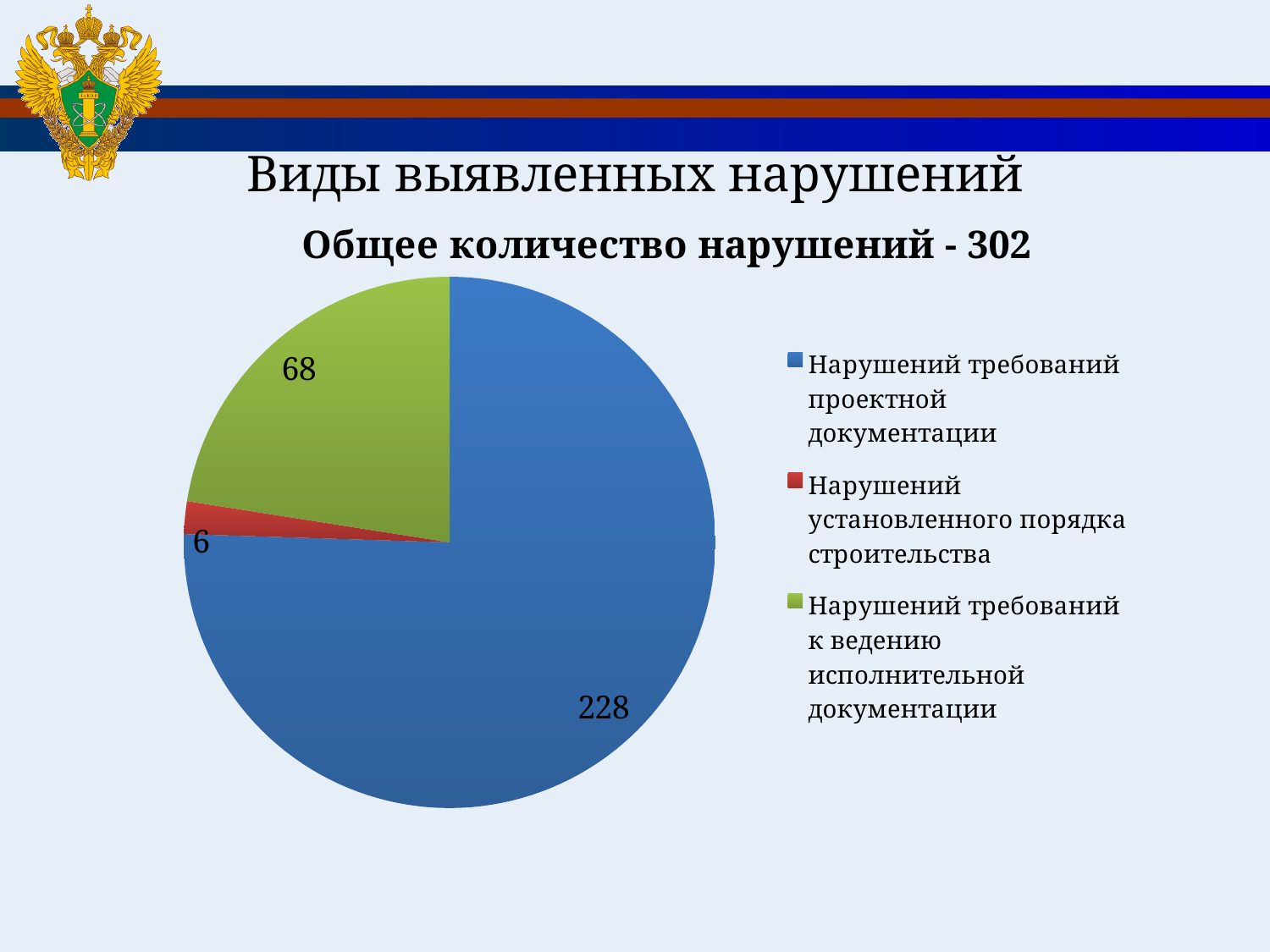
What colour is the slice for 'Нарушений требований к ведению исполнительной документации'? Green What is the value for 'Нарушений требований к ведению исполнительной документации'? 68 How many categories does the pie chart have? 3 Which category has the largest slice of the pie? Нарушений требований проектной документации Which category has the smallest slice of the pie? Нарушений установленного порядка строительства What is the value for 'Нарушений установленного порядка строительства'? 6 What kind of chart is shown on the slide? Pie chart What is the total number of violations stated in the chart title? 302 Which is larger: the value for 'Нарушений требований к ведению исполнительной документации' or for 'Нарушений установленного порядка строительства'? Нарушений требований к ведению исполнительной документации What is the difference between the values for 'Нарушений требований проектной документации' and 'Нарушений требований к ведению исполнительной документации'? 160 What share of the pie does 'Нарушений требований проектной документации' represent? 75.5% What is the value for 'Нарушений требований проектной документации'? 228